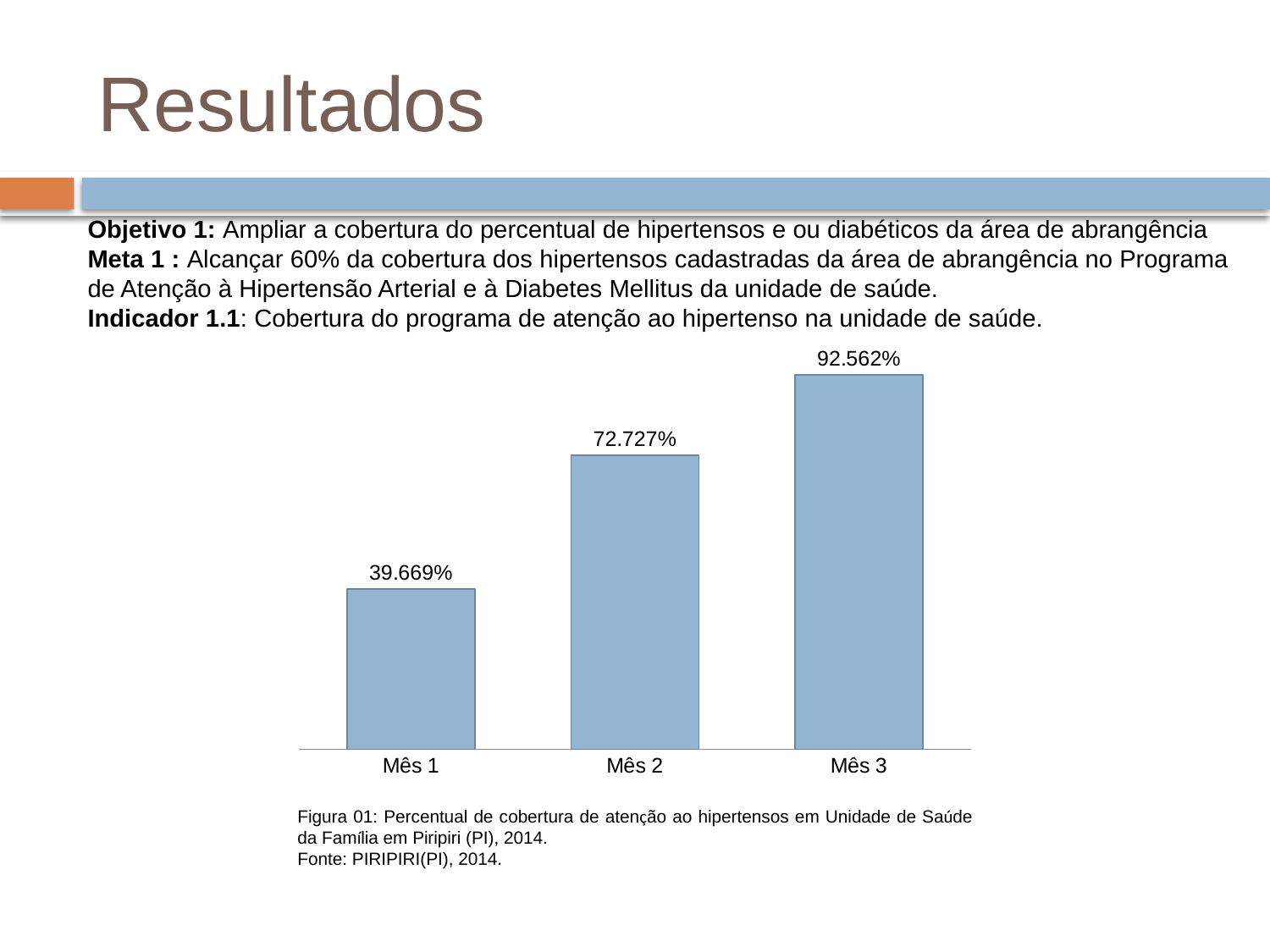
Which month has the lowest value? Mês 1 What is the difference between the values for Mês 3 and Mês 2? 19.835% What is the figure number given in the caption below the chart? Figura 01 What is the value for Mês 2? 72.727% What kind of chart is shown on the slide? bar chart Which month has the highest value? Mês 3 Which is larger, the value for Mês 1 or the value for Mês 2? Mês 2 How many months are shown on the chart? 3 What is the value for Mês 3? 92.562% What is the value for Mês 1? 39.669% What is the difference between the values for Mês 2 and Mês 1? 33.058% Do the values rise or fall from Mês 1 to Mês 3? rise